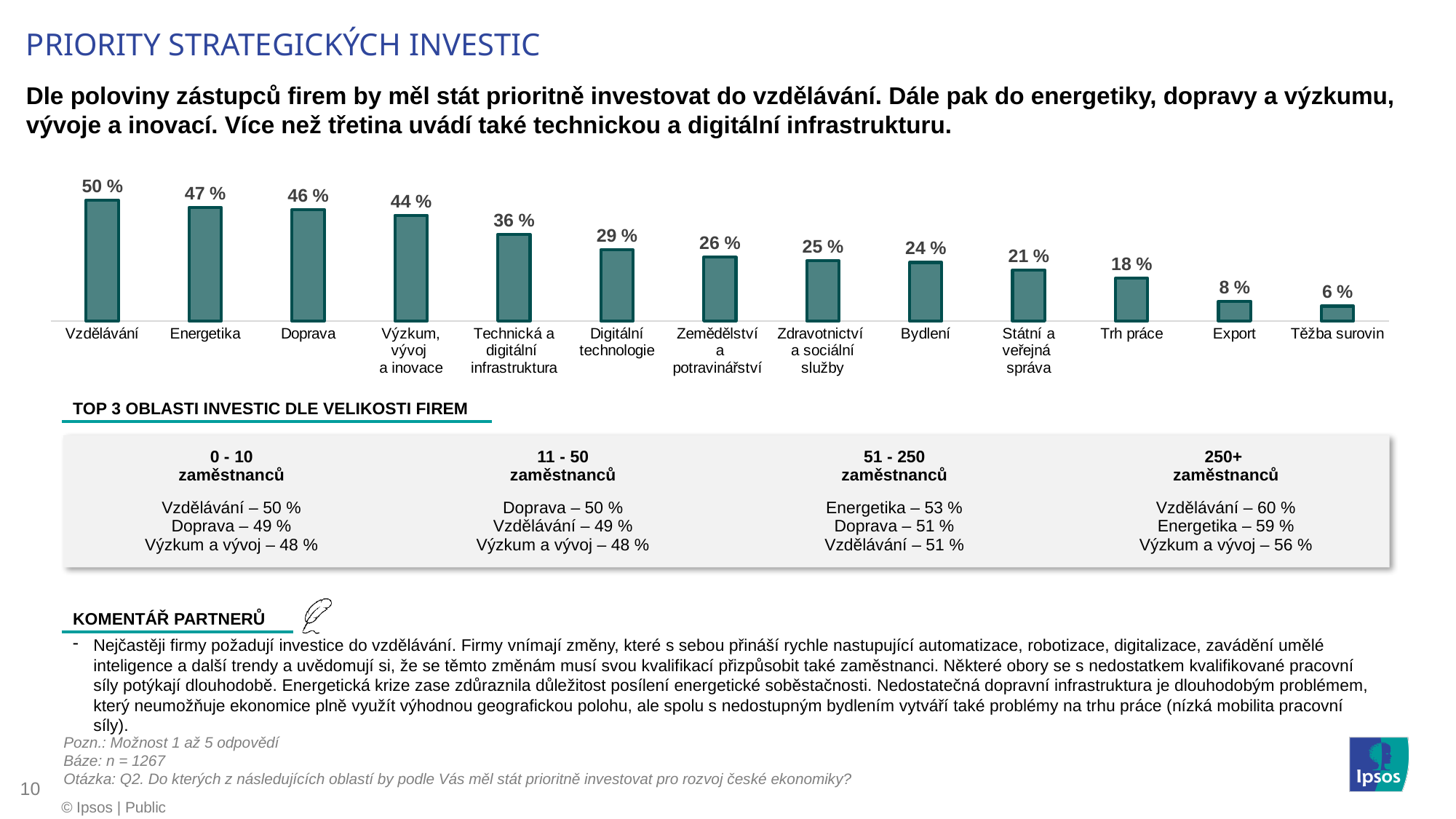
What kind of chart is shown on the slide? Bar chart How many categories are shown in the bar chart? 13 What is the value for Trh práce? 18 % Which category has the lowest value? Těžba surovin Do the values rise or fall from left to right along the x axis? Fall Which is larger, the value for Digitální technologie or the value for Bydlení? Digitální technologie What is the value for Zdravotnictví a sociální služby? 25 % What is the value for Vzdělávání? 50 % What is the value for Technická a digitální infrastruktura? 36 % Which category has the highest value? Vzdělávání What is the difference between the values for Energetika and Doprava? 1 % What is the difference between the values for Vzdělávání and Export? 42 %